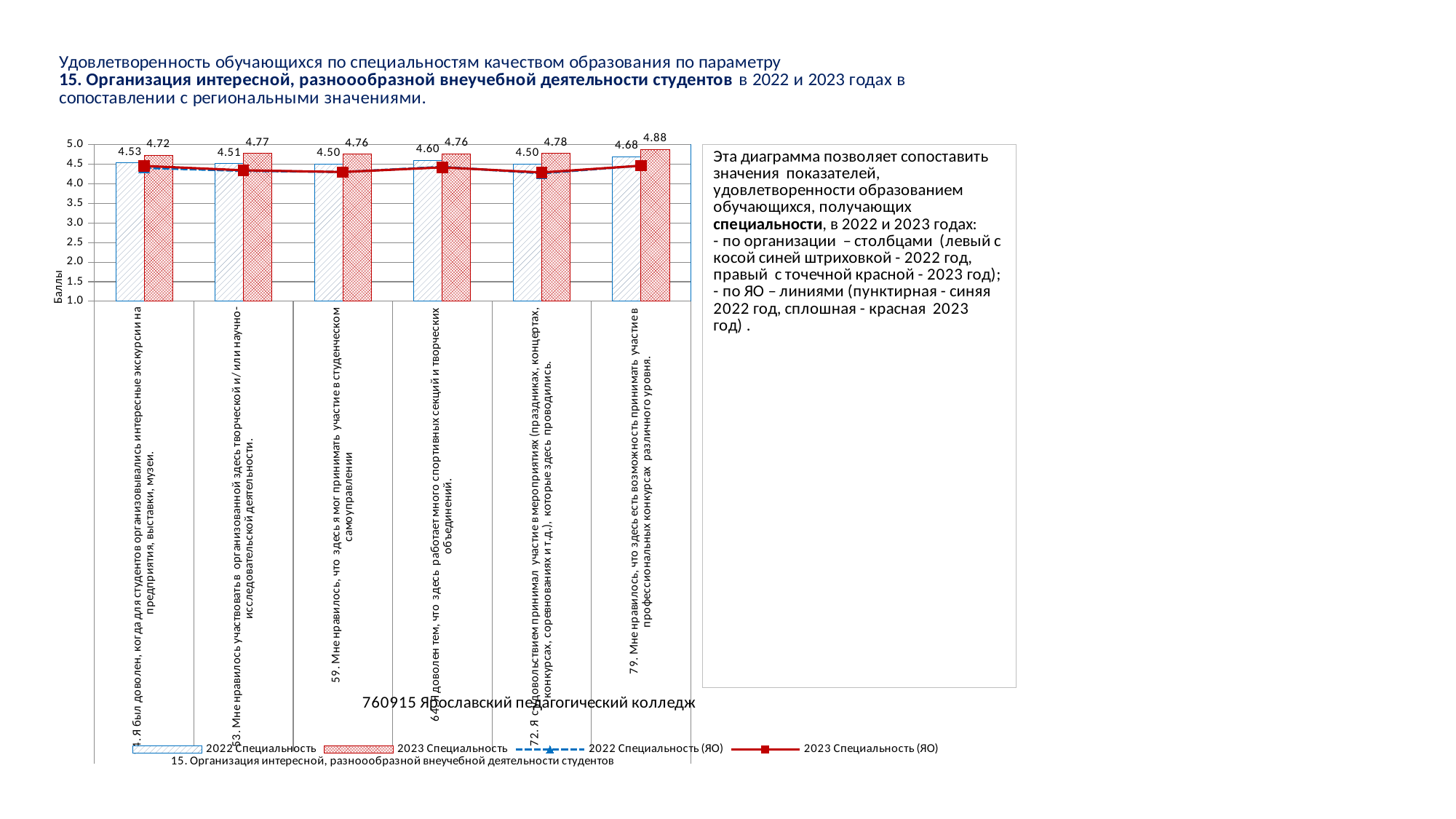
Which category has the highest 2023 Специальность bar? 79. Мне нравилось, что здесь есть возможность принимать участие в профессиональных конкурсах различного уровня How many categories are shown on the x axis of the chart? 6 Is the value of the 2023 Специальность (ЯО) line at the category '59. Мне нравилось, что здесь я мог принимать участие в студенческом самоуправлении' greater or less than 4.0? greater For the category '64. Я доволен тем, что здесь работает много спортивных секций и творческих объединений', which is larger: the 2022 Специальность bar or the 2023 Специальность bar? 2023 Специальность What is the lowest value among the 2023 Специальность bars? 4.72 What is the value of the 2023 Специальность bar for the category '79. Мне нравилось, что здесь есть возможность принимать участие в профессиональных конкурсах различного уровня'? 4.88 How many series does the chart legend list? 4 What is the value of the 2022 Специальность bar for the category '59. Мне нравилось, что здесь я мог принимать участие в студенческом самоуправлении'? 4.50 What is the value of the 2023 Специальность bar for the category '64. Я доволен тем, что здесь работает много спортивных секций и творческих объединений'? 4.76 What is the difference between the 2023 and 2022 Специальность values for the category '79. Мне нравилось, что здесь есть возможность принимать участие в профессиональных конкурсах различного уровня'? 0.20 What kind of chart is shown on the slide? Combined bar and line chart What is the highest value among the 2022 Специальность bars? 4.68